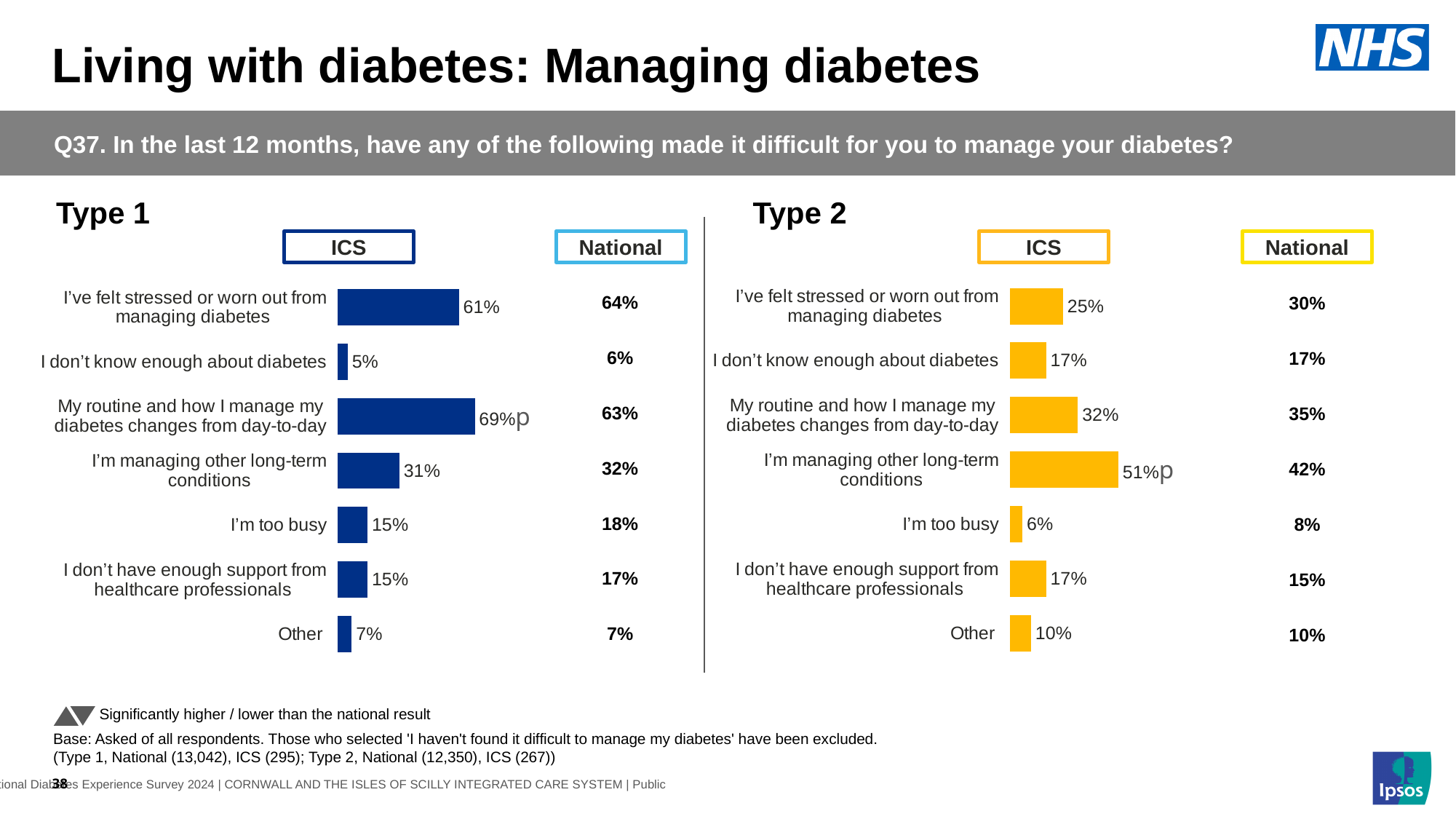
What colour are the ICS bars in the Type 2 chart? Yellow In the Type 2 chart, what is the ICS value for 'I'm managing other long-term conditions'? 51% In the Type 1 chart, what is the ICS value for 'I've felt stressed or worn out from managing diabetes'? 61% In the Type 2 chart, what is the National value for 'My routine and how I manage my diabetes changes from day-to-day'? 35% In the Type 1 chart, what is the difference between the ICS and National values for 'My routine and how I manage my diabetes changes from day-to-day'? 6 percentage points In the Type 2 chart, which category has the lowest ICS value? I'm too busy In the Type 2 chart, what is the difference between the ICS and National values for 'I'm managing other long-term conditions'? 9 percentage points In the Type 2 chart, is the ICS value for 'I've felt stressed or worn out from managing diabetes' larger or smaller than the National value? smaller What type of chart is used to show the ICS values on this slide? Bar chart How many categories are shown in the Type 1 chart? 7 In the Type 1 chart, which category has the highest ICS value? My routine and how I manage my diabetes changes from day-to-day In the Type 1 chart, what is the National value for 'I'm too busy'? 18%